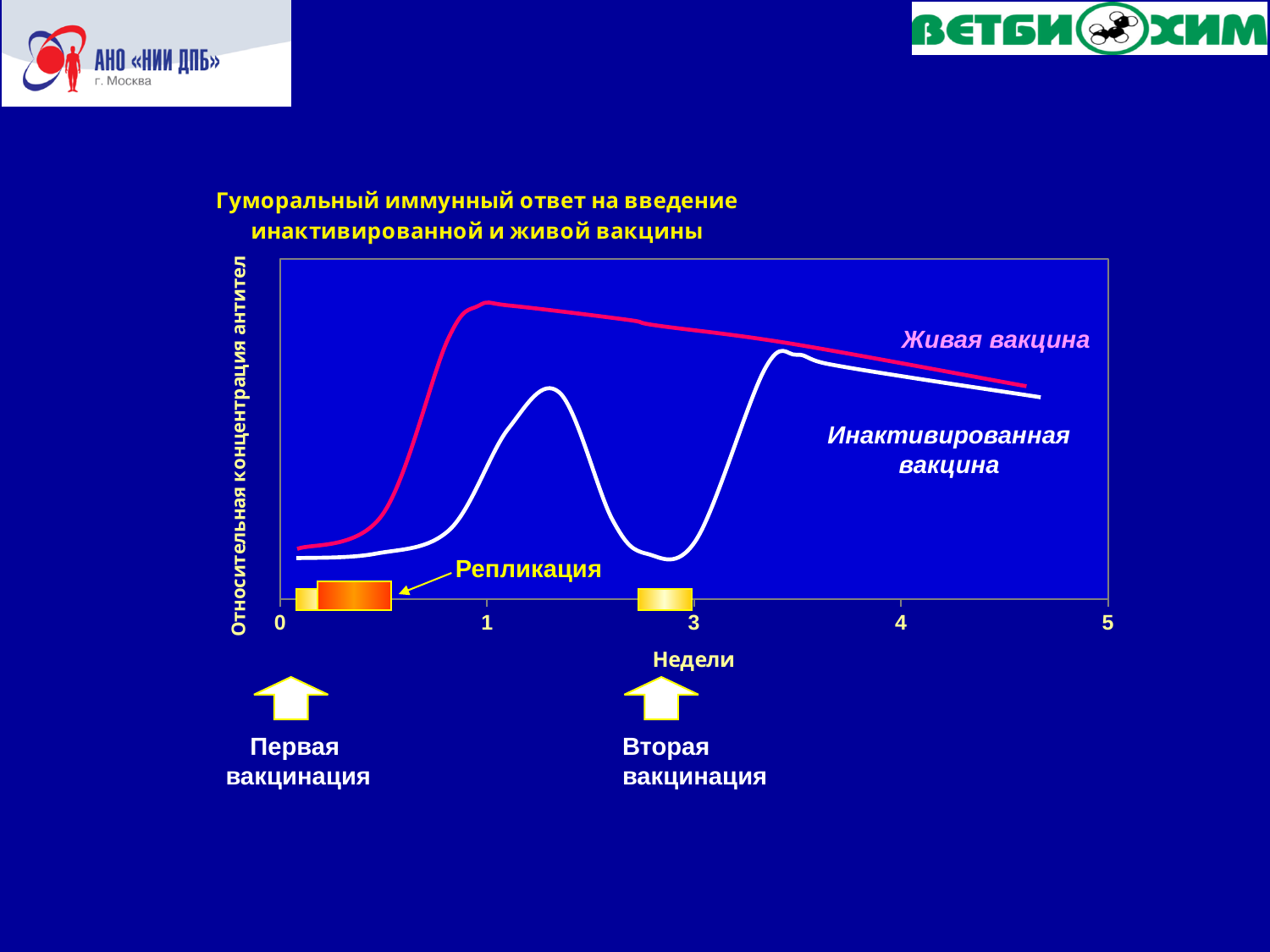
What is the title of the chart? Гуморальный иммунный ответ на введение инактивированной и живой вакцины Which curve reaches the higher peak, Живая вакцина or Инактивированная вакцина? Живая вакцина What is the highest value shown on the x axis? 5 Which curve shows two separate peaks? Инактивированная вакцина What kind of chart is shown on the slide? line chart At which week on the x axis is the first vaccination (Первая вакцинация) marked? 0 What is the label of the x axis? Недели Between week 2 and week 3, does the Инактивированная вакцина curve rise or fall? fall How many curves (series) are plotted on the chart? 2 Between week 0 and week 1, does the Живая вакцина curve rise or fall? rise Between week 1 and week 4, does the Живая вакцина curve rise or fall? fall What is the lowest value shown on the x axis? 0